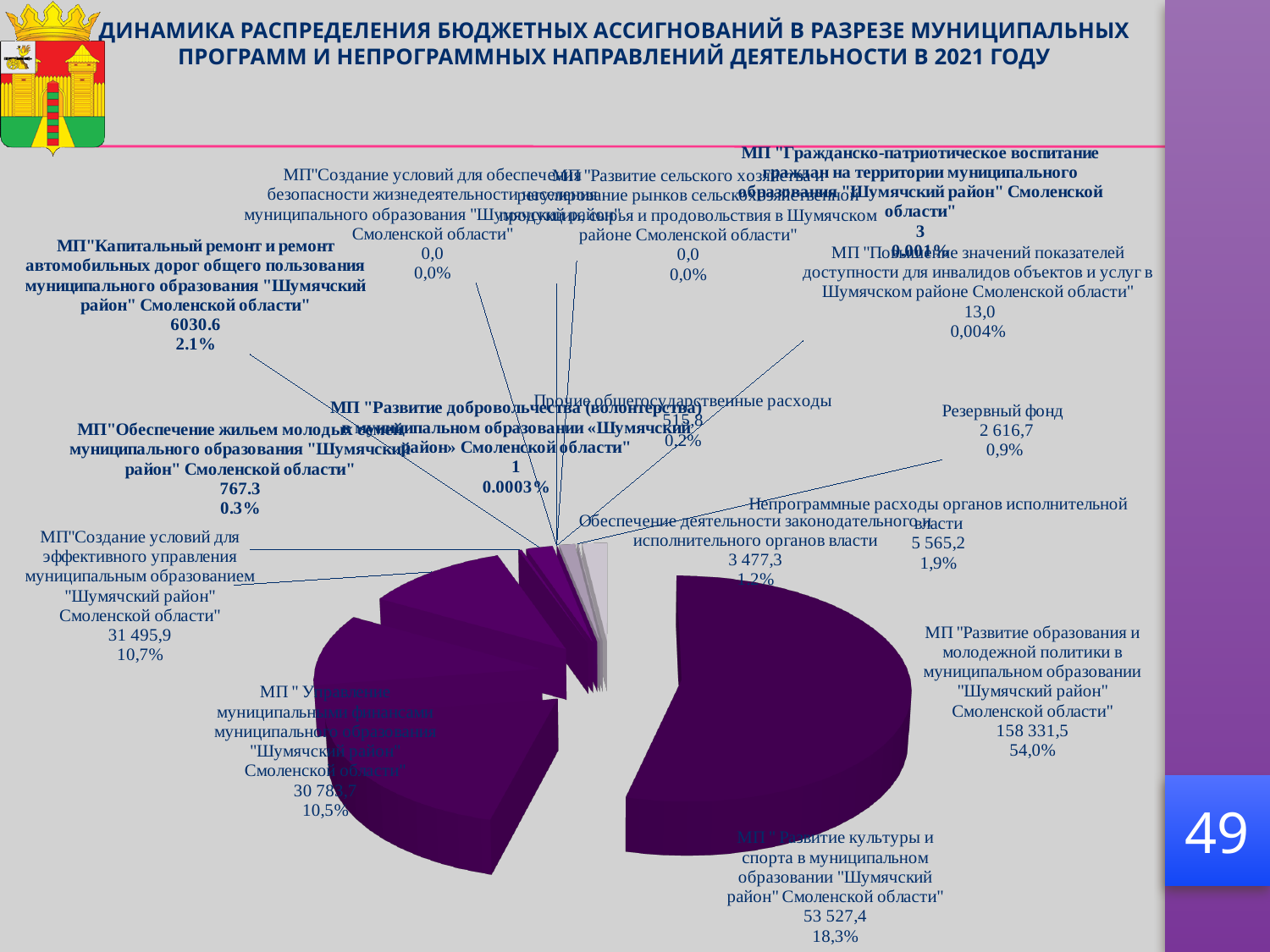
What kind of chart is shown on the slide? Pie chart Which category has the largest share of the pie? МП "Развитие образования и молодежной политики в муниципальном образовании "Шумячский район" Смоленской области" Which is larger: the value for Обеспечение деятельности законодательного и исполнительного органов власти or the value for Резервный фонд? Обеспечение деятельности законодательного и исполнительного органов власти What is the value shown for МП "Развитие культуры и спорта"? 53 527,4 What is the value shown for МП "Развитие образования и молодежной политики"? 158 331,5 What share of the pie does МП "Развитие образования и молодежной политики" hold? 54,0% What is the value shown for Прочие общегосударственные расходы? 515,8 What is the value shown for Резервный фонд? 2 616,7 What share of the pie does МП "Создание условий для эффективного управления муниципальным образованием" hold? 10,7% What is the difference between the value for Непрограммные расходы органов исполнительной власти and the value for Обеспечение деятельности законодательного и исполнительного органов власти? 2 087,9 What is the value shown for Непрограммные расходы органов исполнительной власти? 5 565,2 What share of the pie does МП "Развитие культуры и спорта" hold? 18,3%